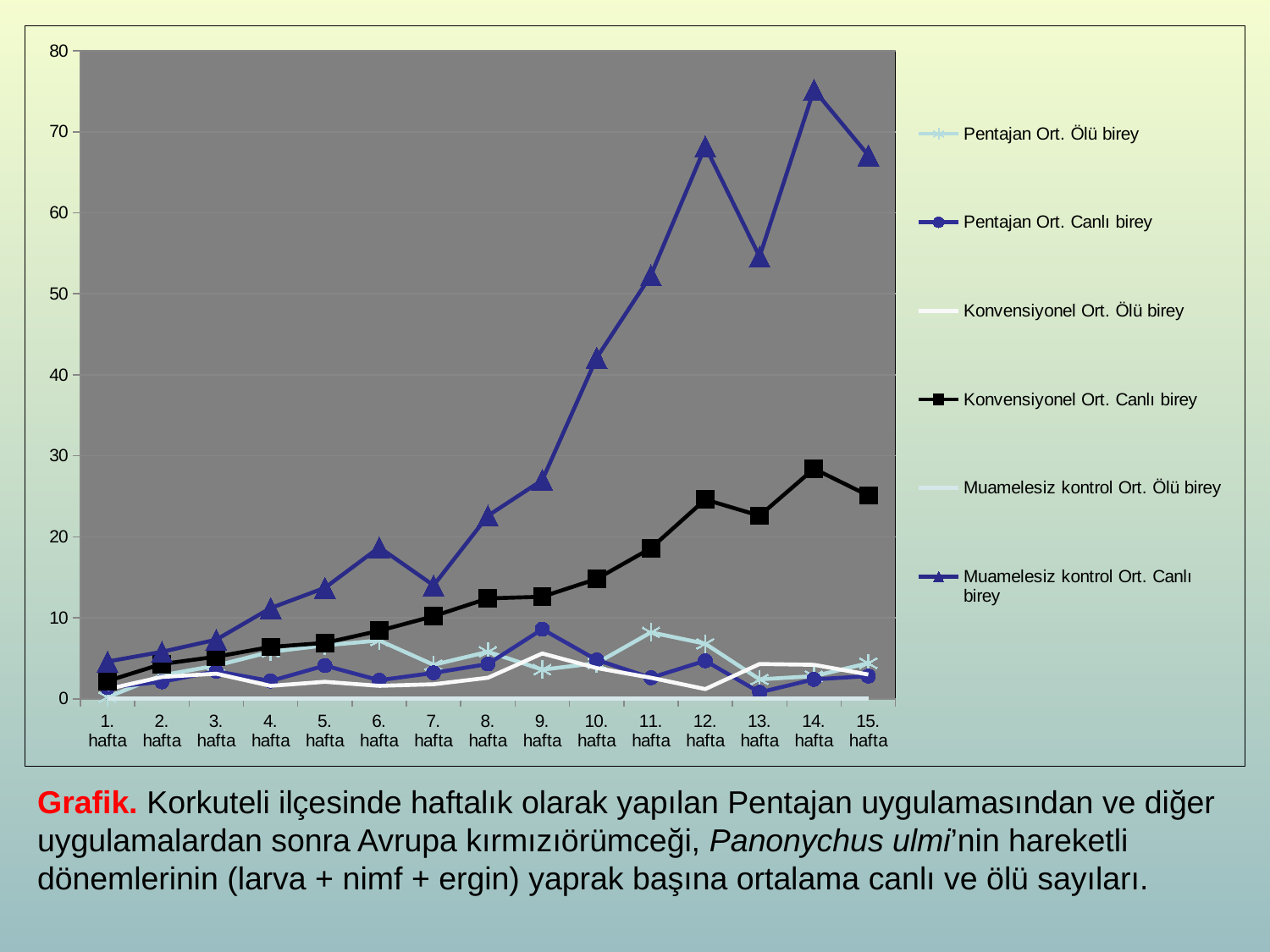
Is the value for 'Konvensiyonel Ort. Canlı birey' at 14. hafta greater or less than 20? greater What kind of chart is shown on the slide? line chart In which week does the series 'Muamelesiz kontrol Ort. Canlı birey' reach its highest value? 14. hafta How many weeks (hafta) are shown on the x axis? 15 Is the value for 'Muamelesiz kontrol Ort. Canlı birey' at 13. hafta greater or less than 50? greater In which week does the series 'Konvensiyonel Ort. Canlı birey' reach its highest value? 14. hafta At 15. hafta, which is larger: 'Pentajan Ort. Canlı birey' or 'Konvensiyonel Ort. Canlı birey'? Konvensiyonel Ort. Canlı birey At 12. hafta, which is larger: 'Muamelesiz kontrol Ort. Canlı birey' or 'Konvensiyonel Ort. Canlı birey'? Muamelesiz kontrol Ort. Canlı birey How many series does the legend list? 6 Which series is drawn with a black line and square markers? Konvensiyonel Ort. Canlı birey Is the value for 'Muamelesiz kontrol Ort. Canlı birey' at 14. hafta greater or less than 70? greater Does the series 'Konvensiyonel Ort. Canlı birey' generally rise or fall from 1. hafta to 15. hafta? rise